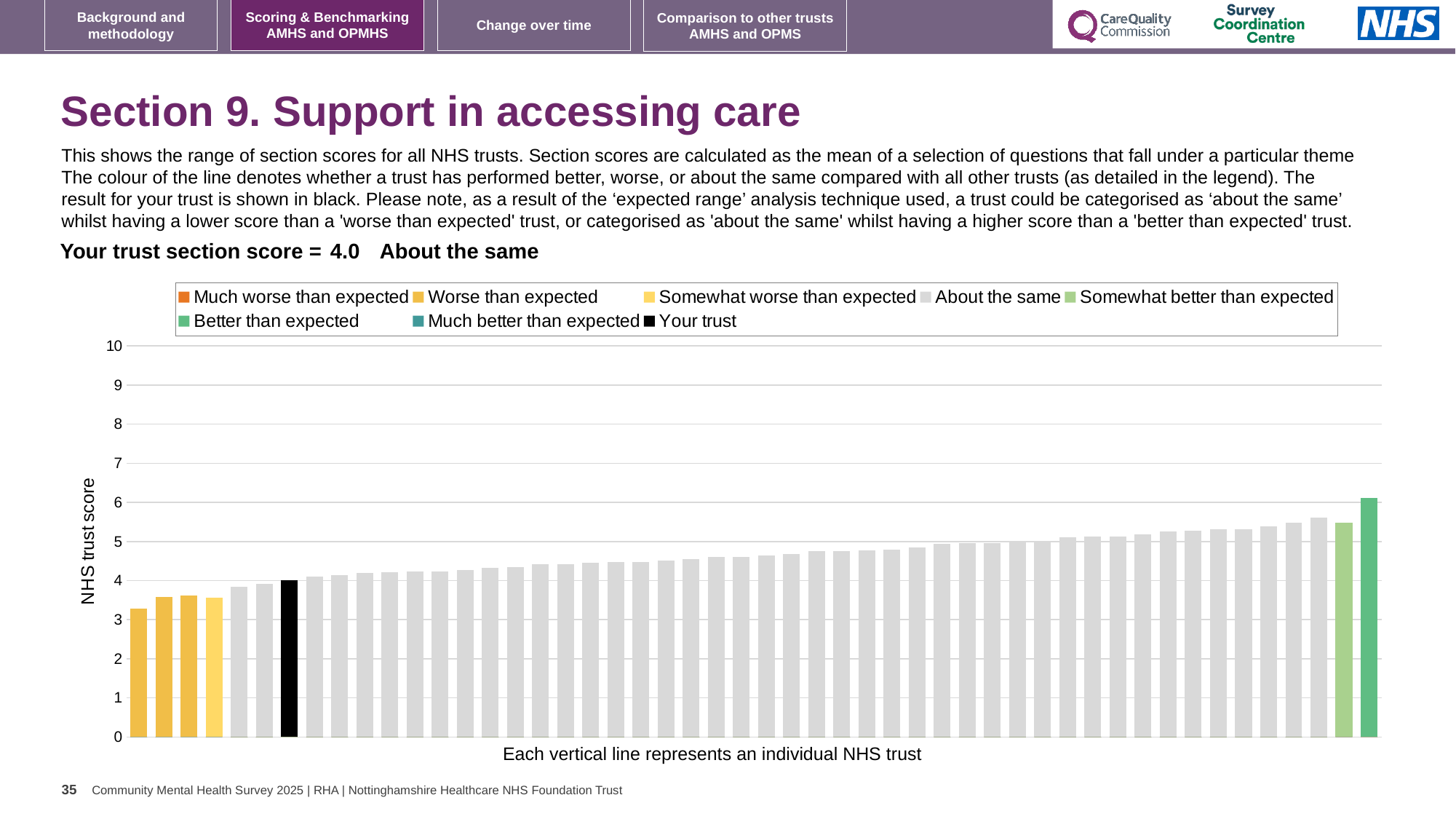
How many entries does the chart legend list? 8 What colour is the bar representing your trust? Black Which benchmarking category is your trust placed in for this section? About the same Is the value of the leftmost bar greater or less than 4? less Do the bar values rise or fall moving from left to right along the x axis? Rise What type of chart is shown on the slide? Bar chart What is the label on the y axis of the chart? NHS trust score Which legend category does the tallest bar belong to? Better than expected Which is larger: the value for your trust (black bar) or the value of the leftmost bar? Your trust What is the section score for your trust shown on the slide? 4.0 Is the value for your trust (the black bar) greater or less than 5? less Is the value of the tallest bar greater or less than 5? greater